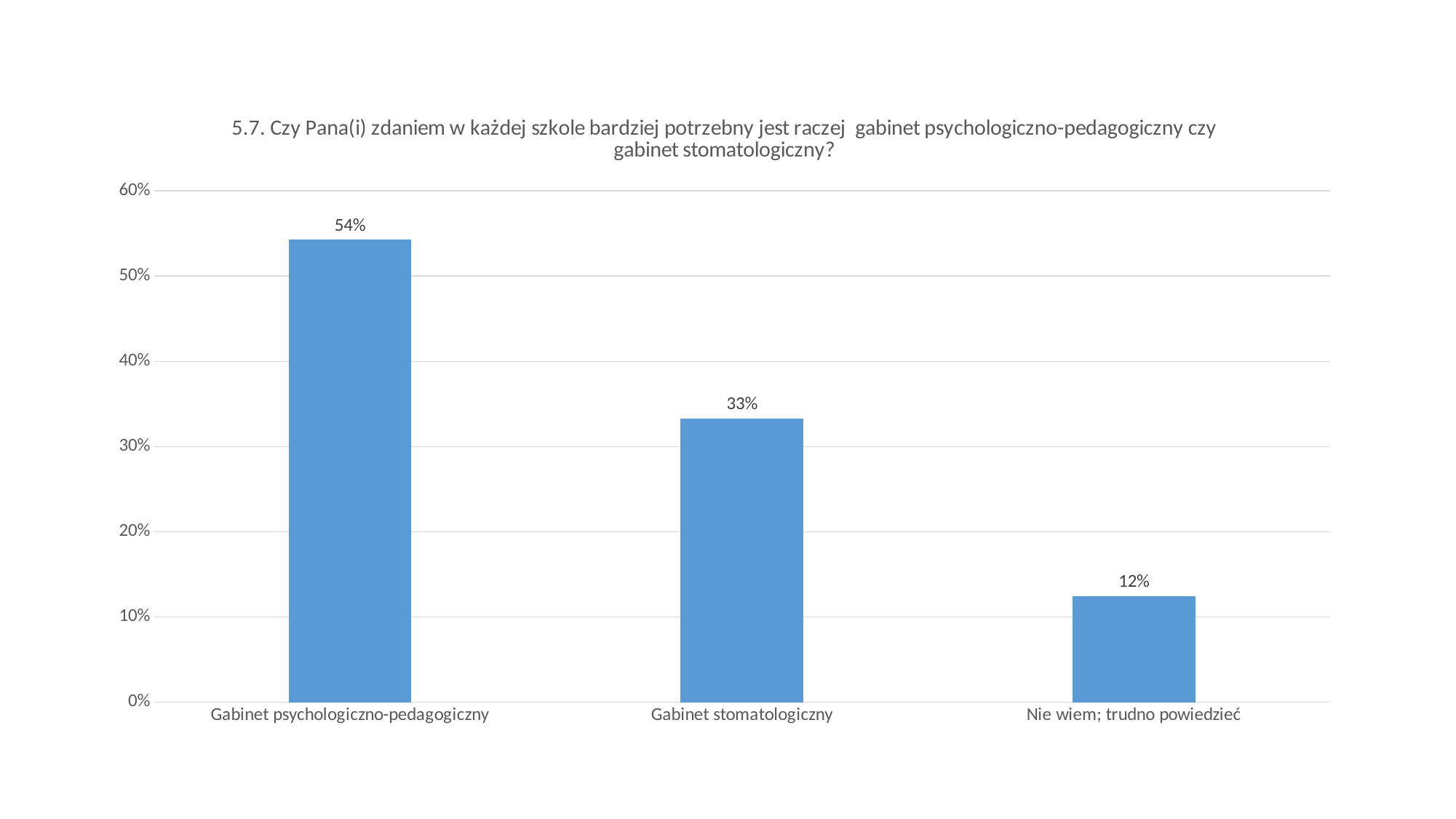
What is the value for "Gabinet psychologiczno-pedagogiczny"? 54% Which is larger, the value for "Gabinet stomatologiczny" or for "Nie wiem; trudno powiedzieć"? Gabinet stomatologiczny Which category has the highest value? Gabinet psychologiczno-pedagogiczny What kind of chart is shown on the slide? bar chart Which category has the lowest value? Nie wiem; trudno powiedzieć What is the difference between the values for "Gabinet psychologiczno-pedagogiczny" and "Gabinet stomatologiczny"? 21% What is the value for "Gabinet stomatologiczny"? 33% How many categories are shown on the x axis? 3 What is the value for "Nie wiem; trudno powiedzieć"? 12% What is the difference between the values for "Gabinet stomatologiczny" and "Nie wiem; trudno powiedzieć"? 21% Is the value for "Gabinet stomatologiczny" greater or less than 40%? less Do the values rise or fall from left to right along the x axis? fall